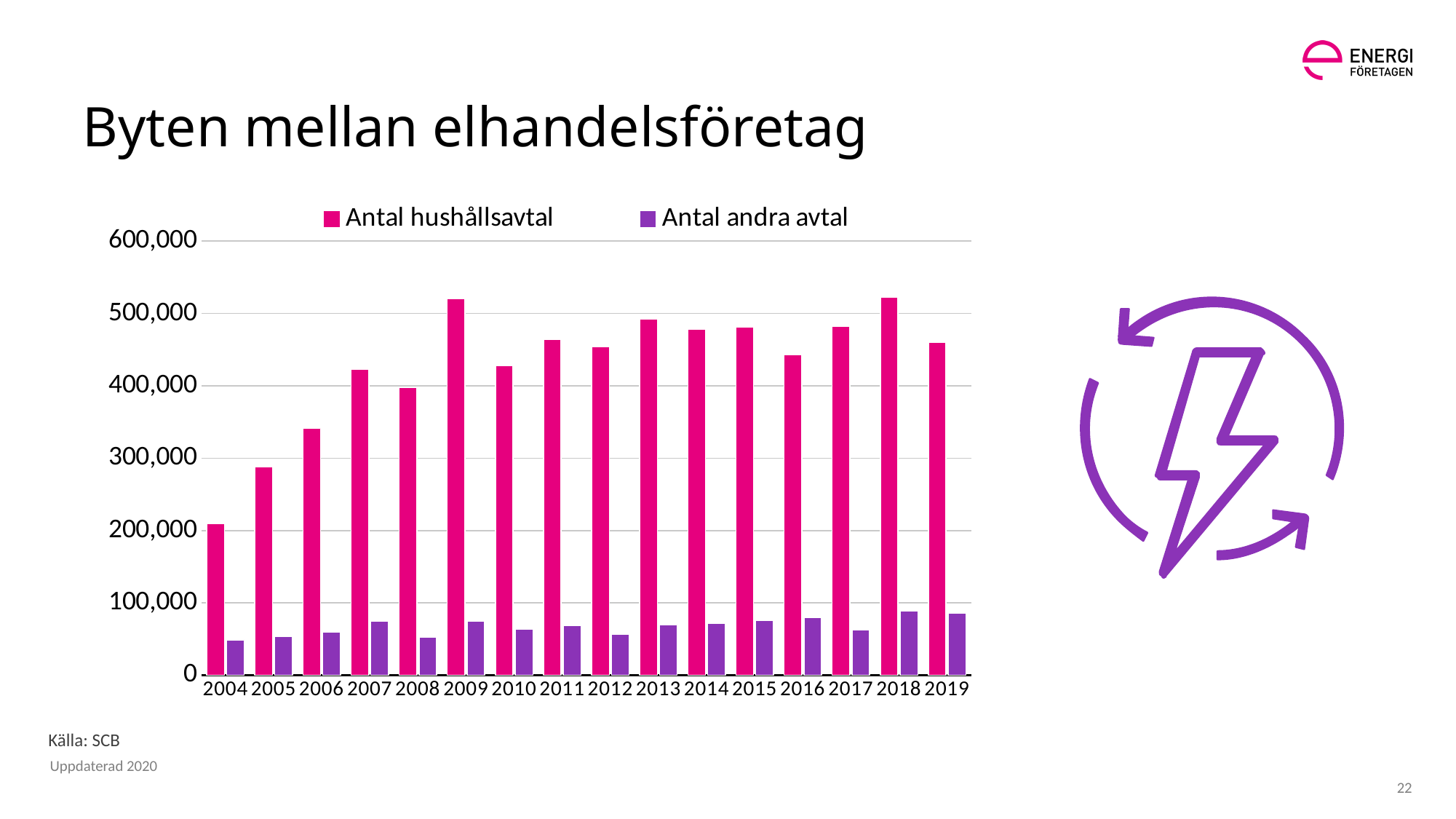
What is the title of the chart on the slide? Byten mellan elhandelsföretag How many series does the legend list? 2 Which year has the lowest value for Antal hushållsavtal? 2004 Is the value for Antal hushållsavtal in 2009 greater or less than 500,000? greater Which is larger, Antal hushållsavtal in 2016 or in 2017? 2017 Is the value for Antal andra avtal in 2018 greater or less than 100,000? less What kind of chart is shown on the slide? bar chart Which is larger, Antal hushållsavtal in 2004 or in 2019? 2019 Is the value for Antal hushållsavtal in 2016 greater or less than 500,000? less Do the values for Antal hushållsavtal rise or fall from 2004 to 2009? rise How many years are shown on the x axis? 16